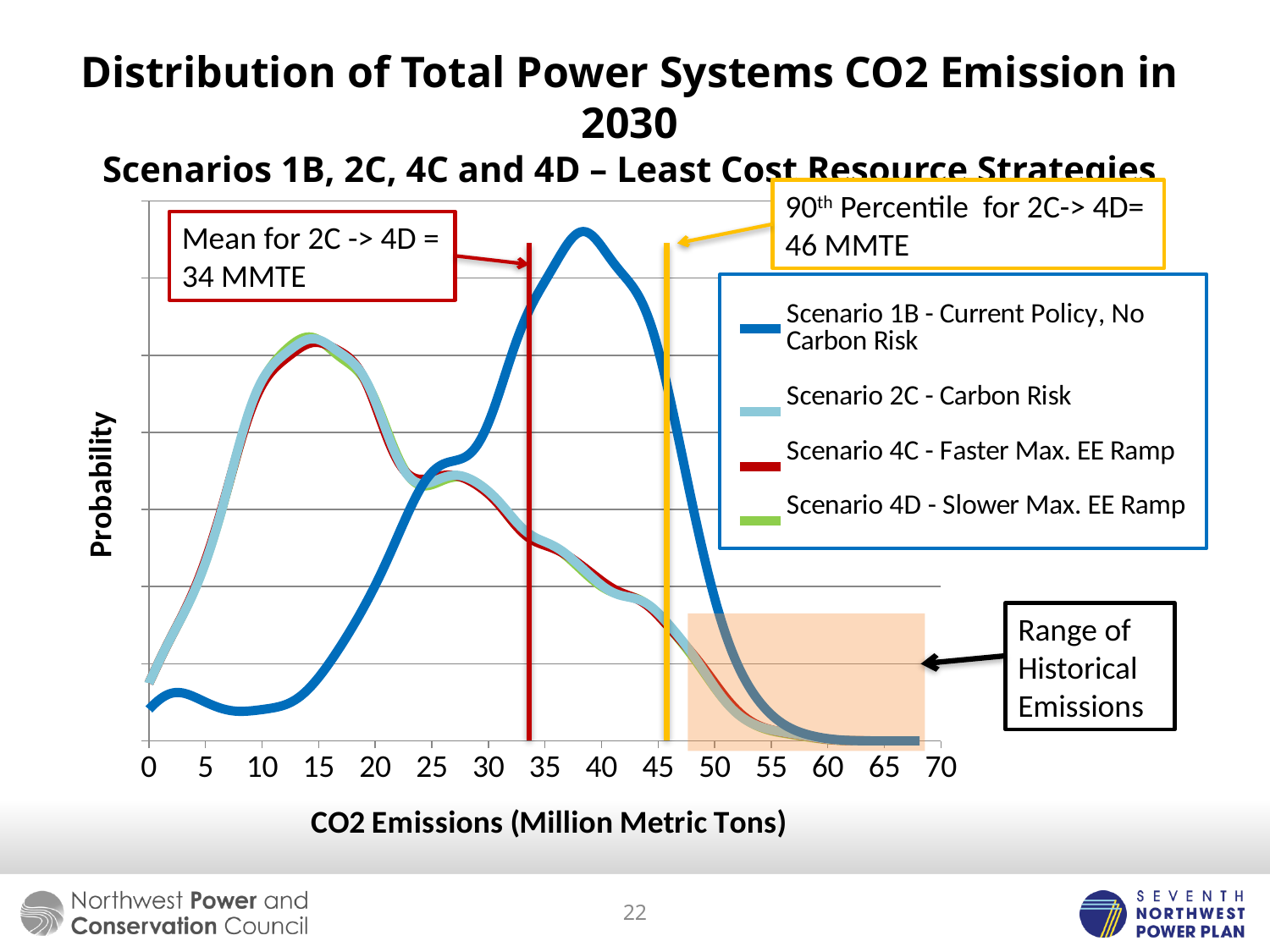
Is the CO2 emission level at which Scenario 4C reaches its highest probability greater or less than 20 million metric tons? less What is the difference between the 90th percentile and the mean for scenarios 2C -> 4D, in MMTE? 12 MMTE Is the CO2 emission level at which Scenario 1B peaks greater or less than 30 million metric tons? greater Does the probability for Scenario 1B rise or fall as CO2 emissions increase from 10 to 35 million metric tons? rise What is the highest value shown on the x axis? 70 What is the label of the y axis? Probability How many series does the legend list? 4 What kind of chart is shown on the slide? line chart According to the annotation, what is the mean CO2 emission for scenarios 2C -> 4D? 34 MMTE Which scenario's distribution peaks at a higher CO2 emission level: Scenario 1B or Scenario 2C? Scenario 1B What is the label of the x axis? CO2 Emissions (Million Metric Tons) According to the annotation, what is the 90th percentile CO2 emission for scenarios 2C -> 4D? 46 MMTE